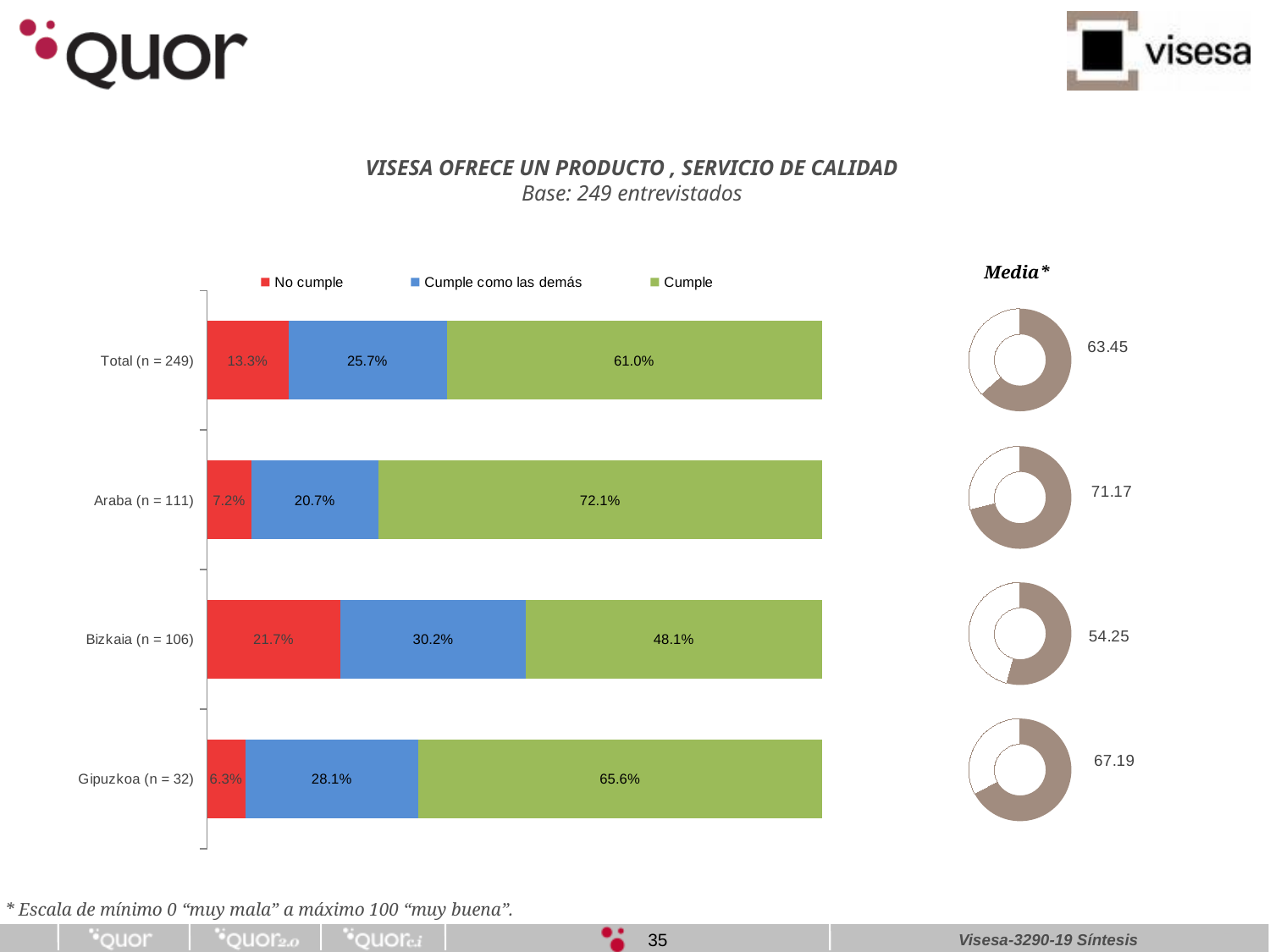
In the stacked bar chart, which category has the lowest 'No cumple' value? Gipuzkoa (n = 32) How many categories does the stacked bar chart show? 4 In the stacked bar chart, what is the 'Cumple' value for Araba (n = 111)? 72.1% In the 'Media*' donut charts on the right, what is the value shown for Bizkaia (n = 106)? 54.25 In the stacked bar chart, what is the 'Cumple como las demás' value for Gipuzkoa (n = 32)? 28.1% In the stacked bar chart, what is the 'No cumple' value for Bizkaia (n = 106)? 21.7% In the 'Media*' donut charts on the right, which category has the highest value? Araba (n = 111) In the stacked bar chart, which is larger: the 'Cumple como las demás' value for Bizkaia (n = 106) or for Total (n = 249)? Bizkaia (n = 106) What kind of chart is the main chart on the left of the slide? Stacked bar chart How many series does the legend of the stacked bar chart list? 3 In the stacked bar chart, which category has the highest 'Cumple' value? Araba (n = 111) In the stacked bar chart, what is the difference between the 'Cumple' values for Araba (n = 111) and Bizkaia (n = 106)? 24.0%